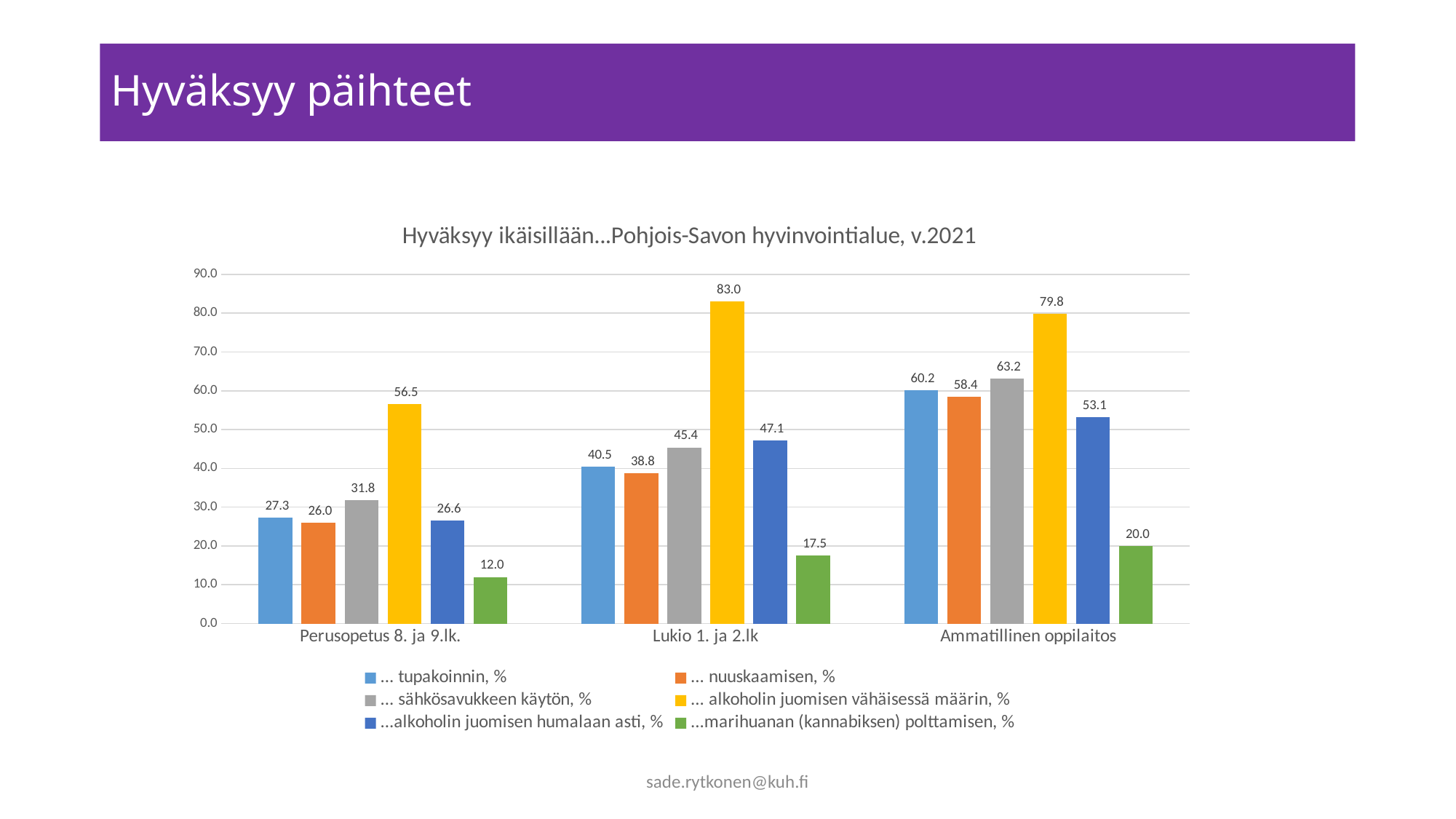
Which category has the highest value for '... alkoholin juomisen vähäisessä määrin, %'? Lukio 1. ja 2.lk Which is larger: '... nuuskaamisen, %' for 'Lukio 1. ja 2.lk' or '...alkoholin juomisen humalaan asti, %' for 'Lukio 1. ja 2.lk'? ...alkoholin juomisen humalaan asti, % What kind of chart is shown on the slide? bar chart Which series has the lowest value in the 'Ammatillinen oppilaitos' category? ...marihuanan (kannabiksen) polttamisen, % What is the value for '... alkoholin juomisen vähäisessä määrin, %' in the 'Ammatillinen oppilaitos' category? 79.8 How many categories are shown on the x axis? 3 What is the value for '... tupakoinnin, %' in the 'Lukio 1. ja 2.lk' category? 40.5 How many series does the legend list? 6 What is the value for '...marihuanan (kannabiksen) polttamisen, %' in the 'Perusopetus 8. ja 9.lk.' category? 12.0 What is the title of the chart? Hyväksyy ikäisillään…Pohjois-Savon hyvinvointialue, v.2021 What is the difference between the '... sähkösavukkeen käytön, %' values for 'Ammatillinen oppilaitos' and 'Perusopetus 8. ja 9.lk.'? 31.4 Is the value for '...alkoholin juomisen humalaan asti, %' in 'Ammatillinen oppilaitos' greater or less than 50.0? greater